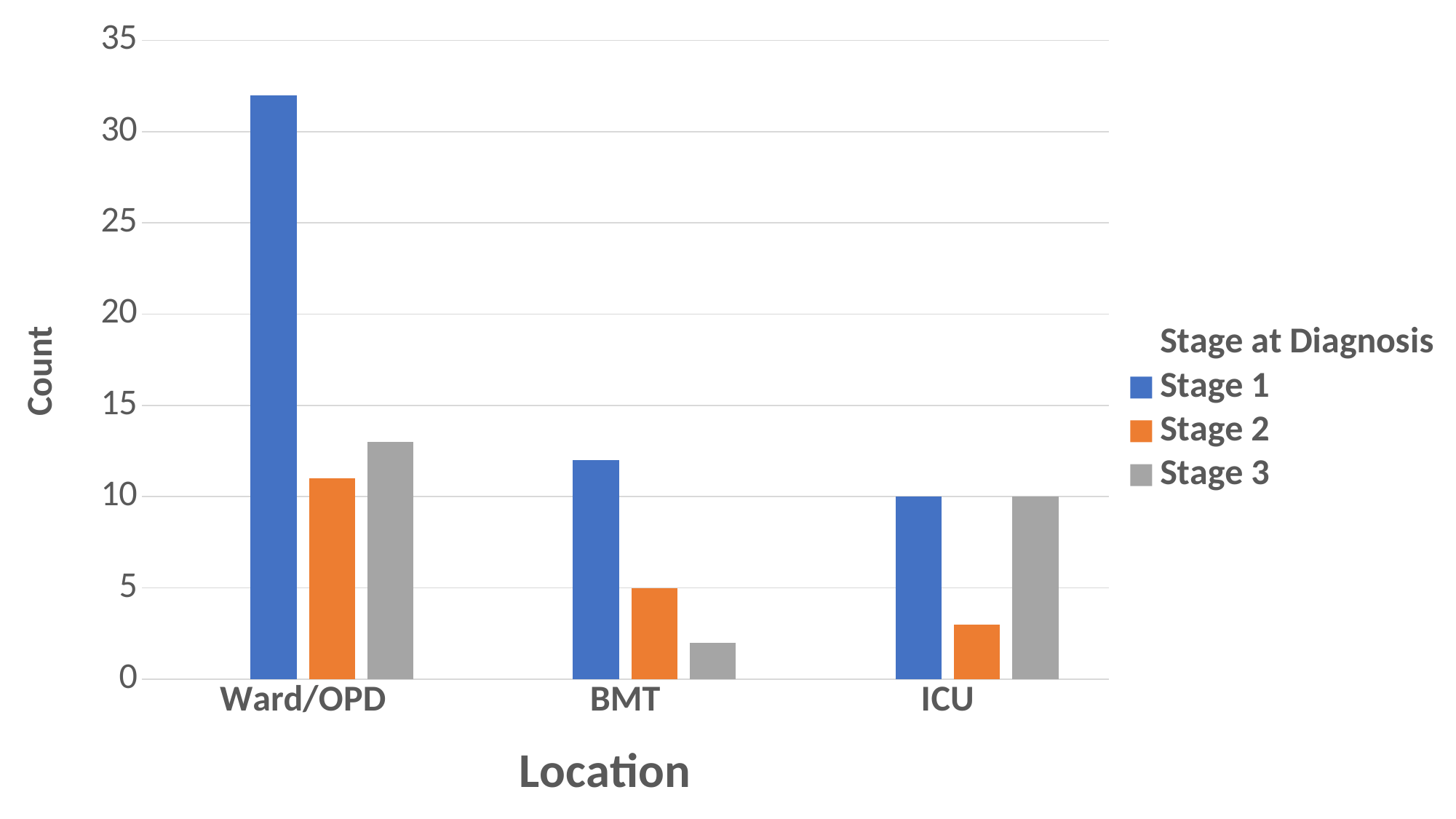
Which is larger for Ward/OPD, the Stage 2 count or the Stage 3 count? Stage 3 Is the Stage 1 value for Ward/OPD greater or less than 30? greater What is the Stage 1 count for ICU? 10 What is the Stage 3 count for ICU? 10 Which location has the lowest Stage 3 count? BMT What is the label of the y axis? Count What is the title of the legend? Stage at Diagnosis What kind of chart is shown on the slide? bar chart Which location has the highest Stage 1 count? Ward/OPD How many location categories are shown on the x axis? 3 What is the Stage 2 count for BMT? 5 How many series does the legend list? 3